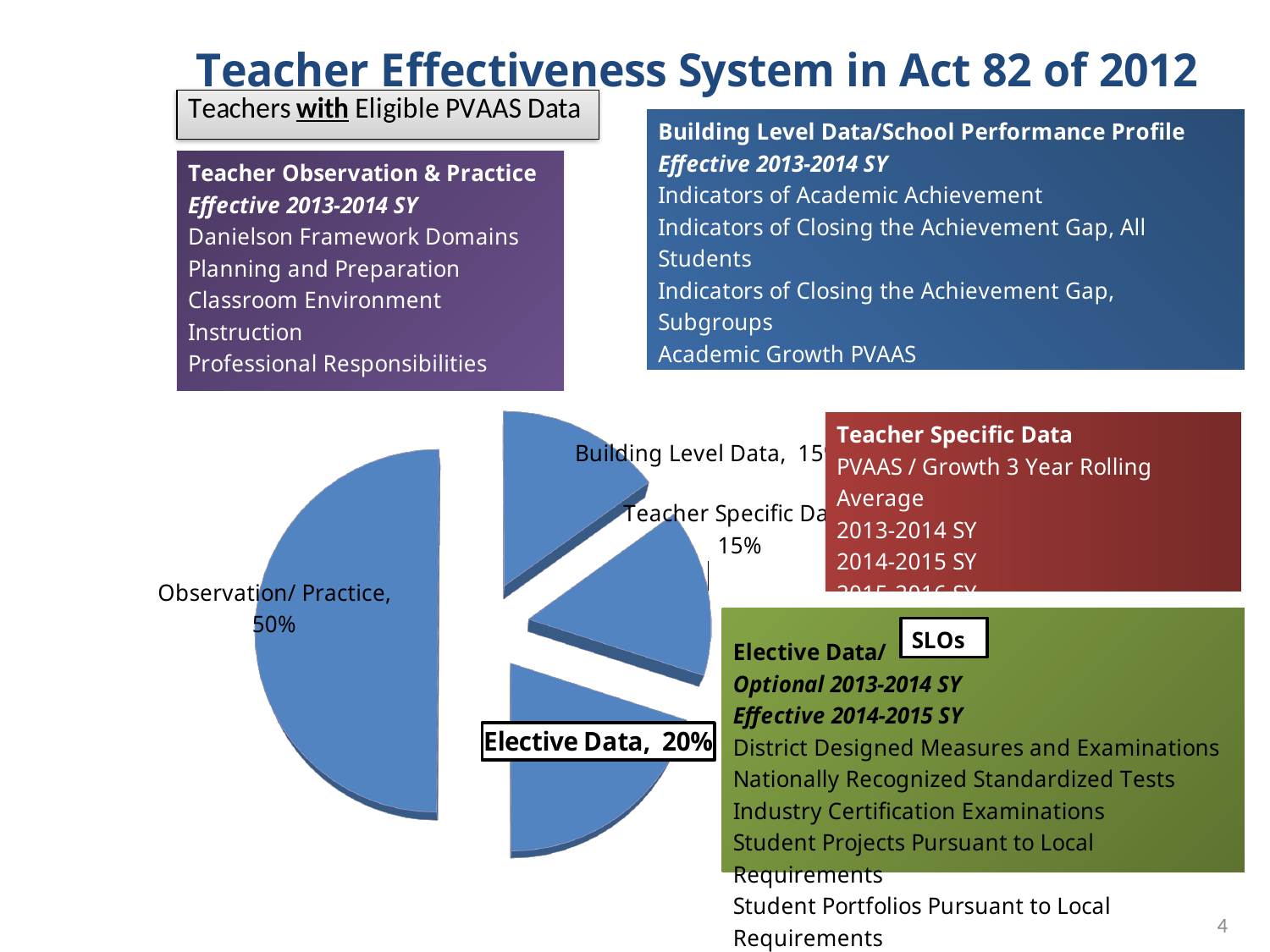
What share of the pie does Observation/ Practice have? 50% What colour are the slices of the pie chart? blue What share of the pie does Teacher Specific Data have? 15% What is the difference between the Observation/ Practice share and the Elective Data share? 30% Which is larger in the pie chart, Observation/ Practice or Building Level Data? Observation/ Practice What share of the pie does Elective Data have? 20% Which is larger in the pie chart, Elective Data or Teacher Specific Data? Elective Data Which slice of the pie chart is the largest? Observation/ Practice How many slices does the pie chart have? 4 What is the difference between the Elective Data share and the Teacher Specific Data share? 5% What kind of chart is shown on the slide? pie chart Is the Building Level Data slice greater or less than 50% of the pie? less